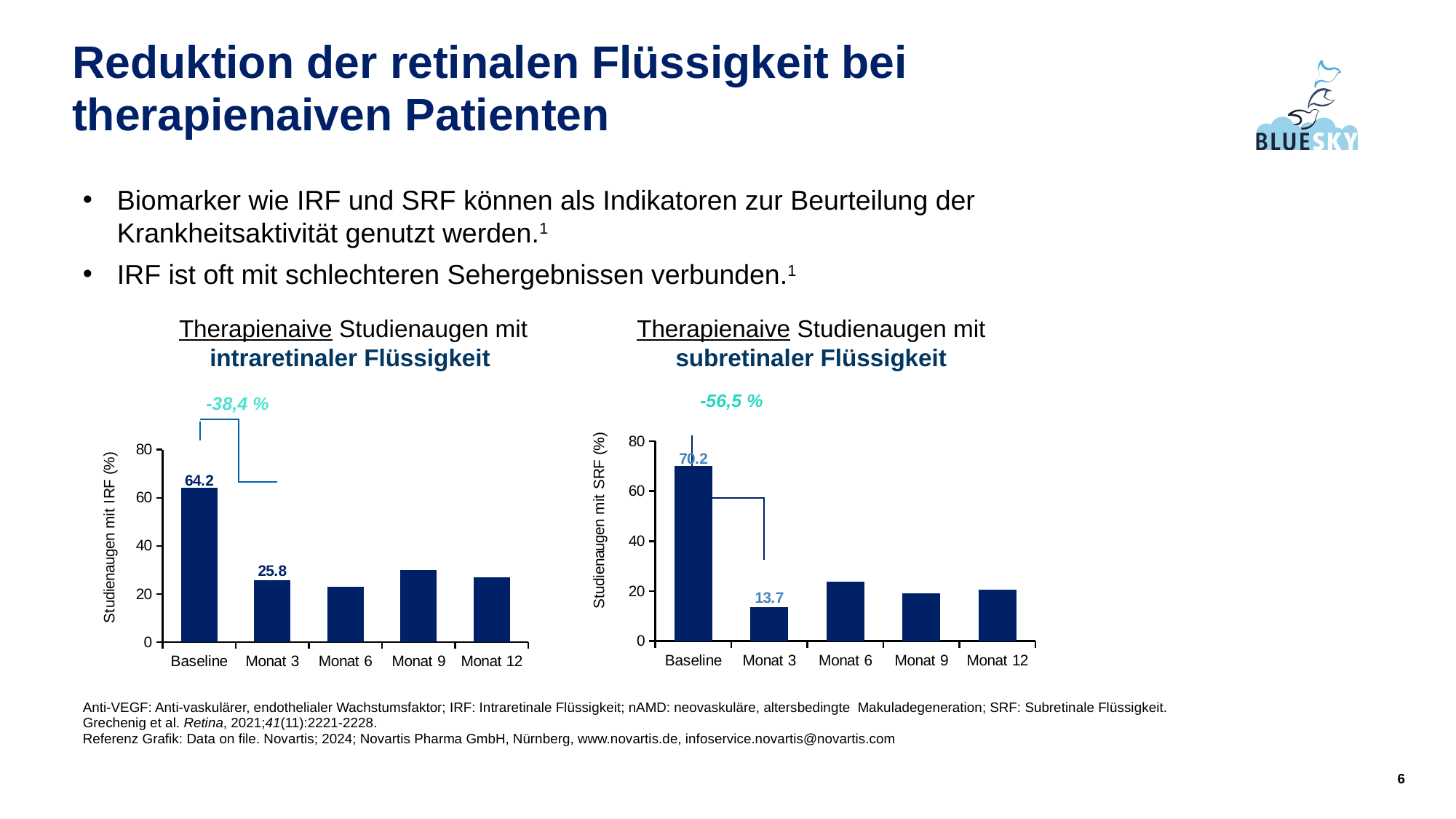
In the chart 'Therapienaive Studienaugen mit intraretinaler Flüssigkeit', what is the difference between the Baseline value and the Monat 3 value? 38.4 What kind of chart is 'Therapienaive Studienaugen mit intraretinaler Flüssigkeit'? bar chart In the chart 'Therapienaive Studienaugen mit intraretinaler Flüssigkeit', what is the value for Monat 3? 25.8 In the chart 'Therapienaive Studienaugen mit intraretinaler Flüssigkeit', which category has the highest value? Baseline In the chart 'Therapienaive Studienaugen mit subretinaler Flüssigkeit', is the value for Monat 6 greater or less than 20? greater In the chart 'Therapienaive Studienaugen mit subretinaler Flüssigkeit', what is the value for Monat 3? 13.7 In the chart 'Therapienaive Studienaugen mit subretinaler Flüssigkeit', what is the value for Baseline? 70.2 In the chart 'Therapienaive Studienaugen mit subretinaler Flüssigkeit', which category has the lowest value? Monat 3 In the chart 'Therapienaive Studienaugen mit intraretinaler Flüssigkeit', what is the value for Baseline? 64.2 In the chart 'Therapienaive Studienaugen mit subretinaler Flüssigkeit', what is the difference between the Baseline value and the Monat 3 value? 56.5 How many categories are shown on the x axis of the chart 'Therapienaive Studienaugen mit subretinaler Flüssigkeit'? 5 In the chart 'Therapienaive Studienaugen mit intraretinaler Flüssigkeit', is the value for Monat 9 greater or less than 40? less